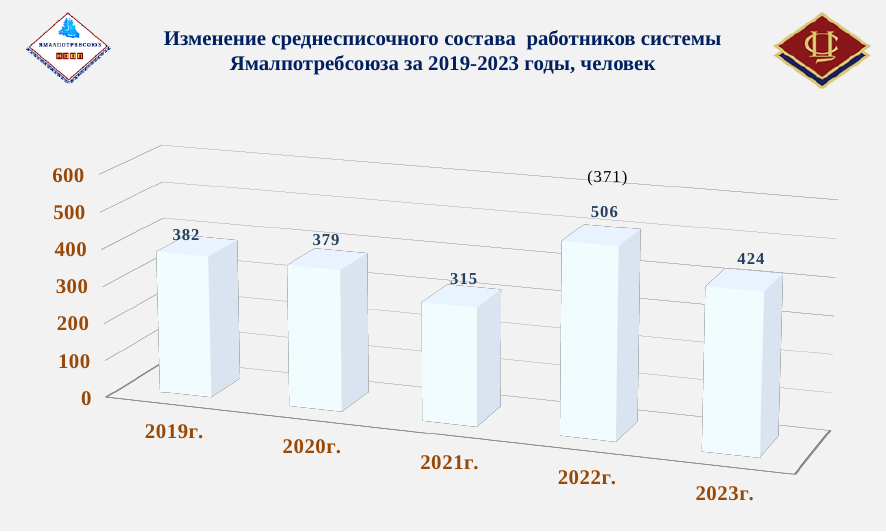
What is the value for 2019г.? 382 What is the difference between the values for 2022г. and 2023г.? 82 Does the value rise or fall from 2019г. to 2021г.? Fall What kind of chart is shown on the slide? Bar chart How many years are shown on the chart? 5 Which is larger, the value for 2020г. or the value for 2023г.? 2023г. What is the value for 2023г.? 424 Which year has the lowest value? 2021г. Which year has the highest value? 2022г. What is the difference between the values for 2019г. and 2021г.? 67 What is the value for 2021г.? 315 What number is shown in parentheses above the 2022г. bar? (371)